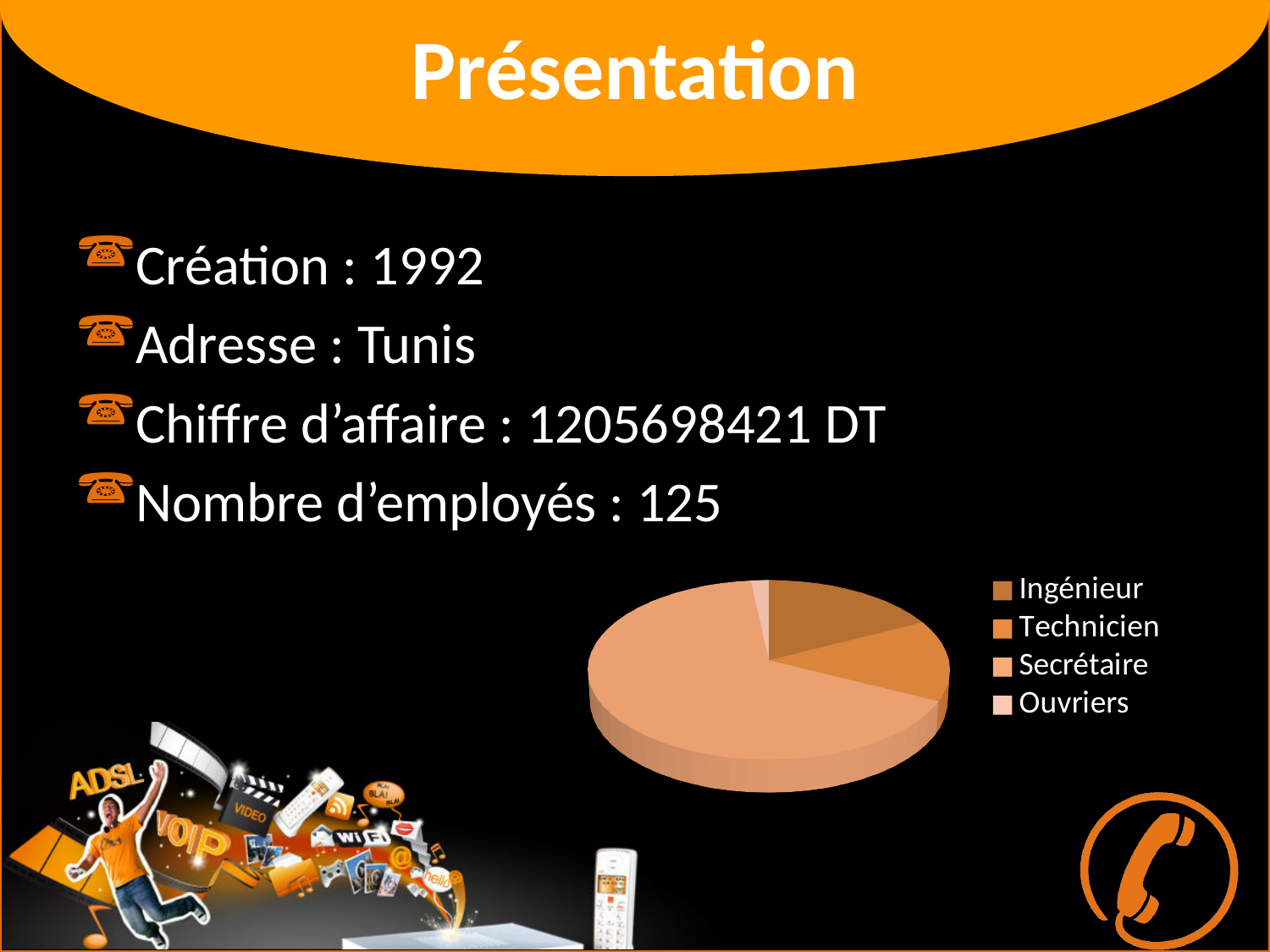
Which category has the largest slice in the pie chart? Secrétaire Which category is listed last in the pie chart's legend? Ouvriers Which is larger in the pie chart, the Ouvriers slice or the Ingénieur slice? Ingénieur Does the Ouvriers slice take up more or less than half of the pie chart? less Which category is listed first in the pie chart's legend? Ingénieur What kind of chart is shown on the slide? pie chart How many categories does the pie chart's legend list? 4